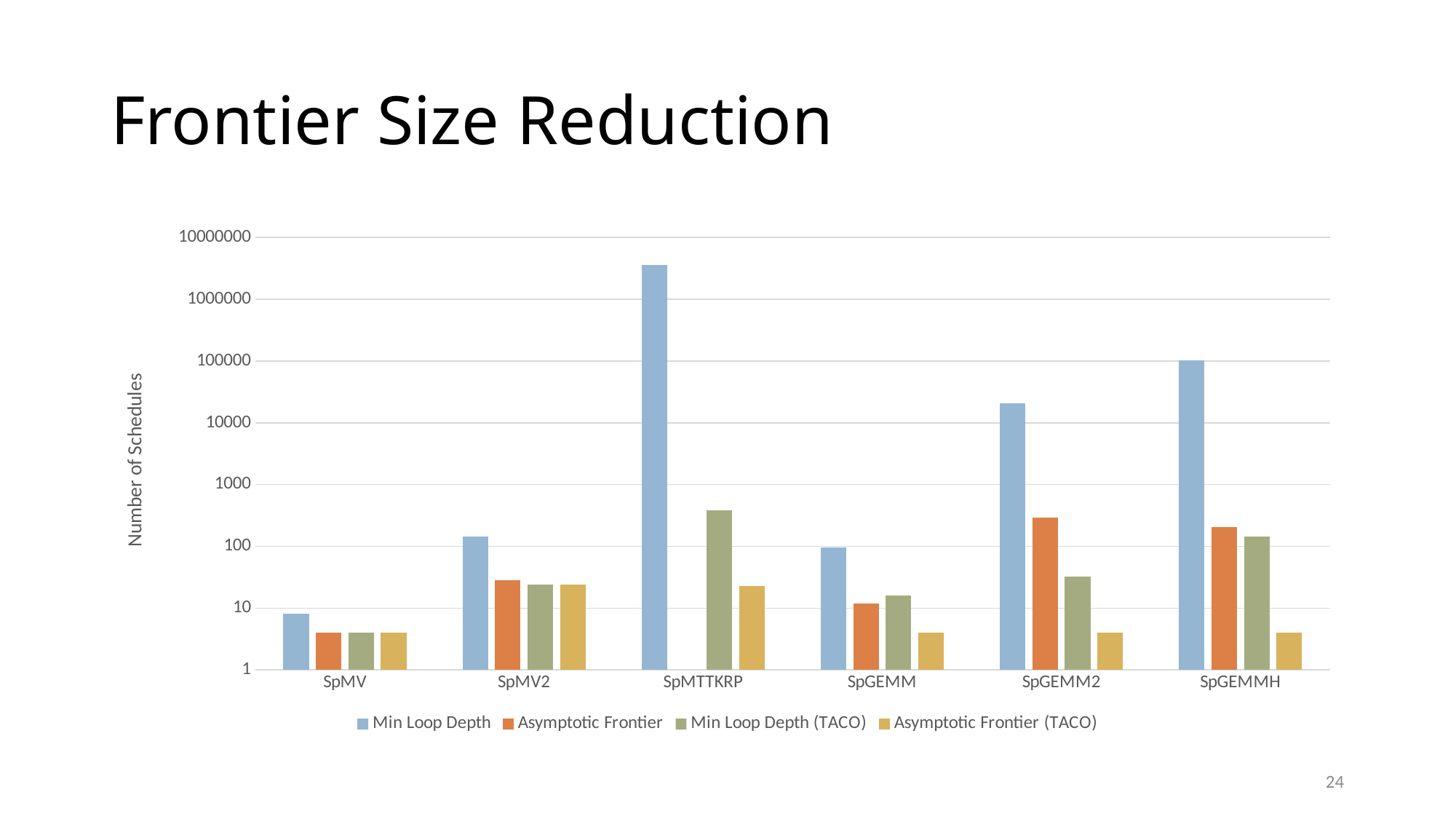
What is the label of the y axis? Number of Schedules Is the Asymptotic Frontier value for SpGEMM2 greater or less than 100? greater For SpGEMM2, which is larger: the Asymptotic Frontier value or the Min Loop Depth (TACO) value? Asymptotic Frontier Which category has the lowest Min Loop Depth value? SpMV Is the Min Loop Depth value for SpMV greater or less than 10? less Is the Min Loop Depth value for SpMTTKRP greater or less than 1000000? greater How many series does the legend list? 4 Which category has the highest Min Loop Depth value? SpMTTKRP How many categories are shown along the x axis? 6 What kind of chart is shown on the slide? bar chart